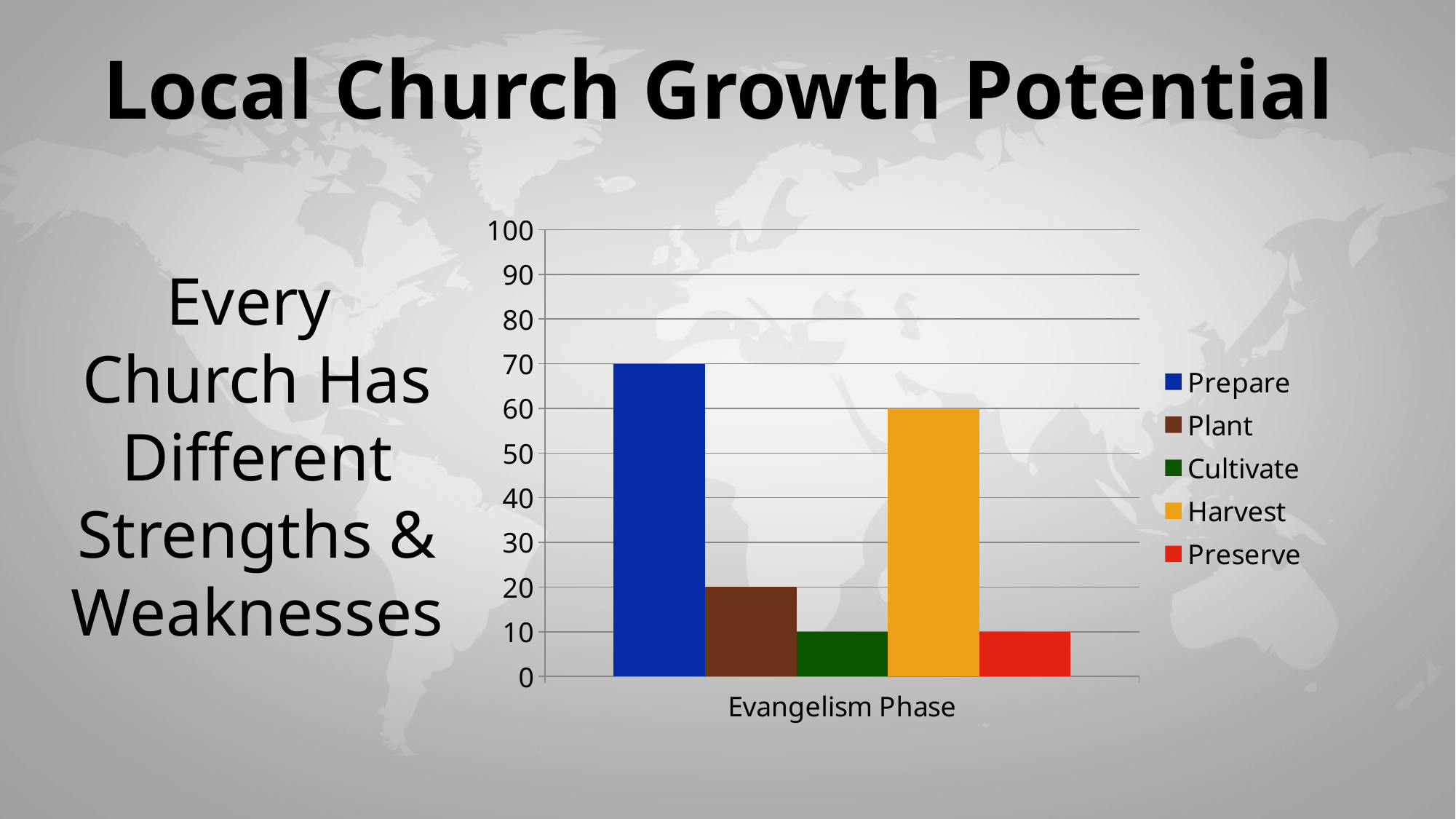
Which is larger, the value for Plant or the value for Preserve? Plant Which series has the highest value? Prepare What is the difference between the values for Prepare and Harvest? 10 What is the value for Prepare? 70 What is the label on the x axis of the chart? Evangelism Phase What is the value for Plant? 20 Is the value for Harvest greater or less than 50? greater How many series does the legend list? 5 What is the difference between the values for Harvest and Plant? 40 What kind of chart is shown on the slide? Bar chart What is the value for Cultivate? 10 What is the value for Harvest? 60